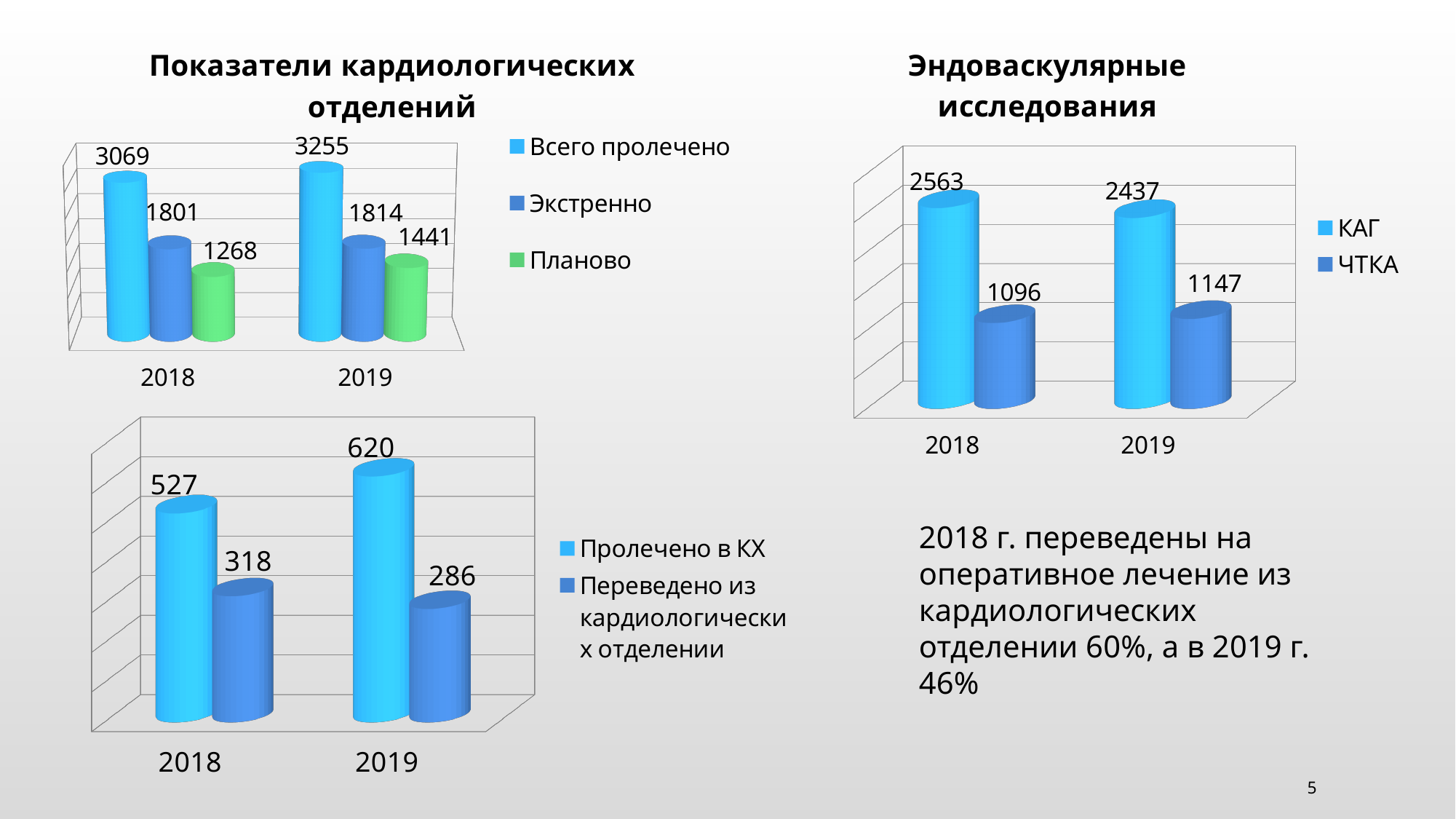
In the chart titled 'Эндоваскулярные исследования', does the value for 'КАГ' rise or fall from 2018 to 2019? fall In the bottom-left chart, what is the value for 'Пролечено в КХ' in 2019? 620 In the chart titled 'Эндоваскулярные исследования', what is the value for 'ЧТКА' in 2019? 1147 In the chart titled 'Эндоваскулярные исследования', what is the difference between 'КАГ' and 'ЧТКА' in 2018? 1467 In the chart titled 'Показатели кардиологических отделений', what is the value for 'Планово' in 2018? 1268 In the chart titled 'Показатели кардиологических отделений', by how much did 'Всего пролечено' change from 2018 to 2019? 186 In the chart titled 'Эндоваскулярные исследования', which year has the higher value for 'КАГ'? 2018 In the bottom-left chart, which year has the lower value for 'Переведено из кардиологических отделении'? 2019 In the bottom-left chart, what is the value for 'Переведено из кардиологических отделении' in 2018? 318 In the chart titled 'Показатели кардиологических отделений', how many series does the legend list? 3 In the chart titled 'Показатели кардиологических отделений', what is the value for 'Всего пролечено' in 2019? 3255 What kind of chart is the bottom-left chart? bar chart